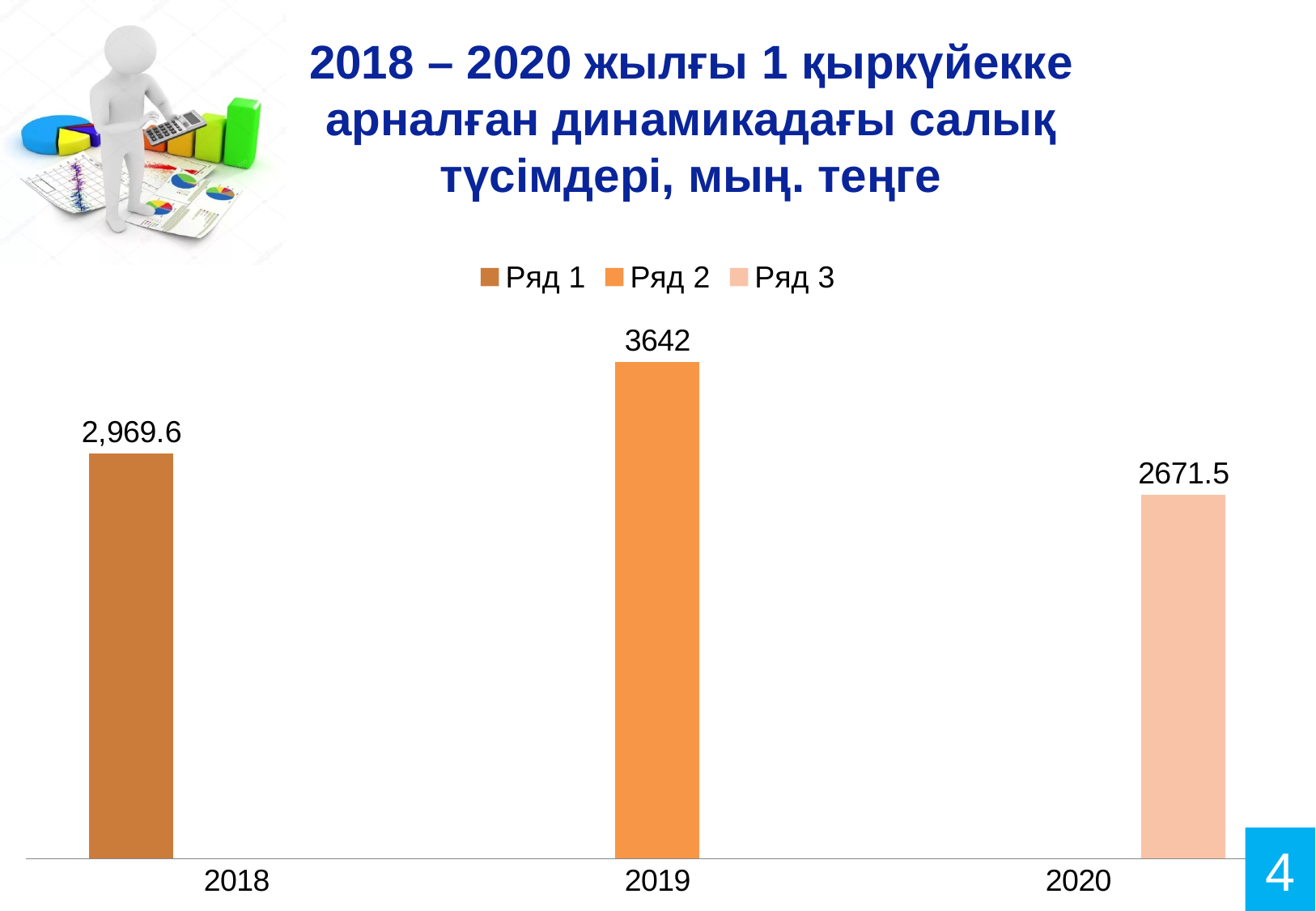
How many series does the legend list? 3 What is the value shown for 2018? 2,969.6 How many years are shown on the x axis? 3 What is the value shown for 2019? 3642 What is the difference between the values for 2019 and 2020? 970.5 What is the difference between the values for 2019 and 2018? 672.4 Which year has the lowest value? 2020 What is the difference between the values for 2018 and 2020? 298.1 What is the value shown for 2020? 2671.5 What kind of chart is shown on the slide? Bar chart Which year has the highest value? 2019 Which is larger, the value for 2018 or the value for 2020? 2018